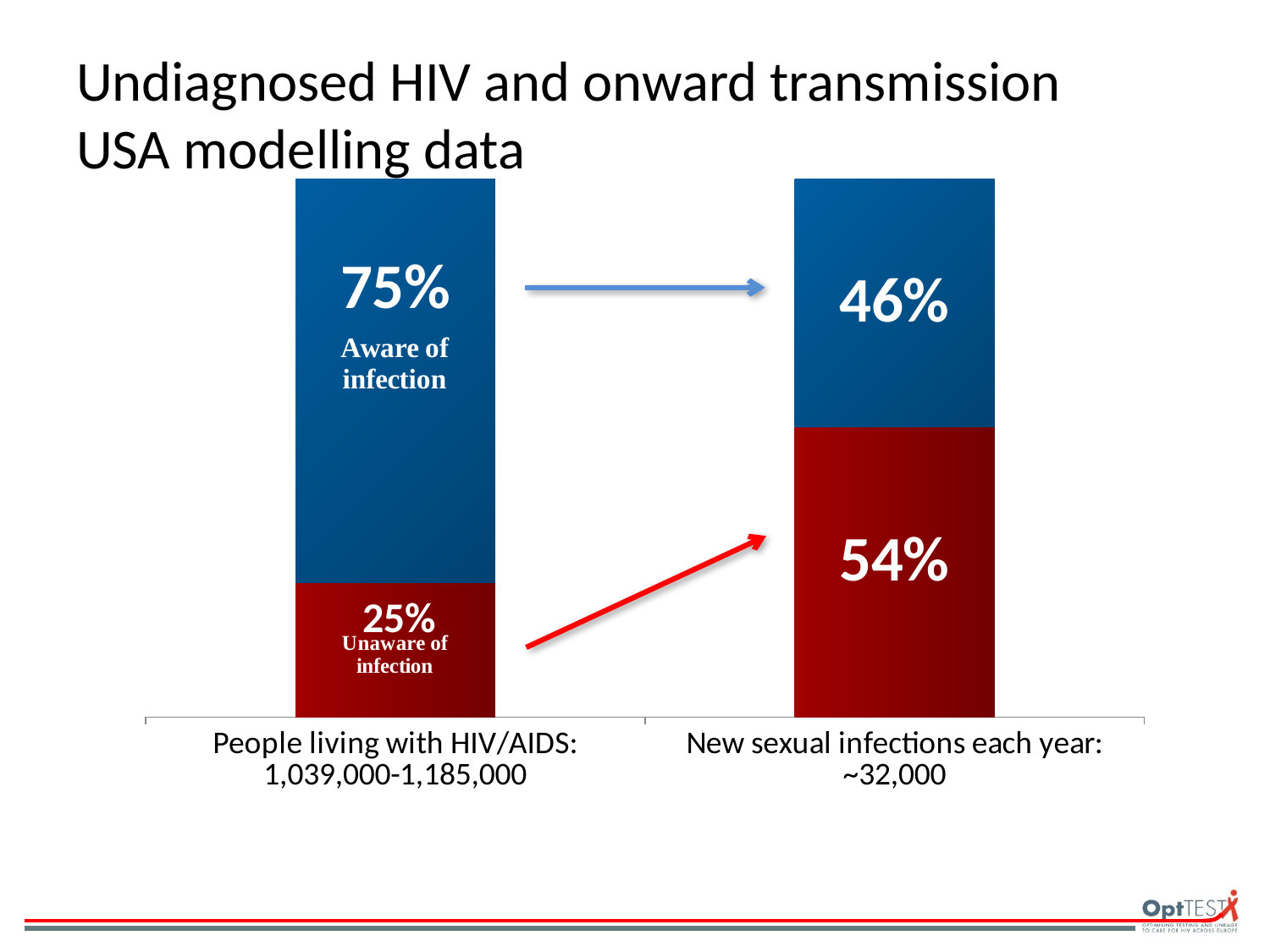
What colour represents people unaware of infection in the chart? Red What share of new sexual infections each year comes from people unaware of their infection? 54% What is the approximate number of new sexual infections each year given in the category label? ~32,000 What share of new sexual infections each year comes from people aware of their infection? 46% What kind of chart is shown on the slide? Stacked bar chart What percentage of people living with HIV/AIDS are aware of their infection? 75% How many bars (categories) are shown in the chart? 2 What percentage of people living with HIV/AIDS are unaware of their infection? 25% What is the difference between the aware and unaware percentages for people living with HIV/AIDS? 50% For new sexual infections each year, which is larger: the share from people aware of infection or from people unaware of infection? Unaware of infection What is the difference between the unaware and aware shares of new sexual infections each year? 8% What is the total of the stacked bar for people living with HIV/AIDS? 100%